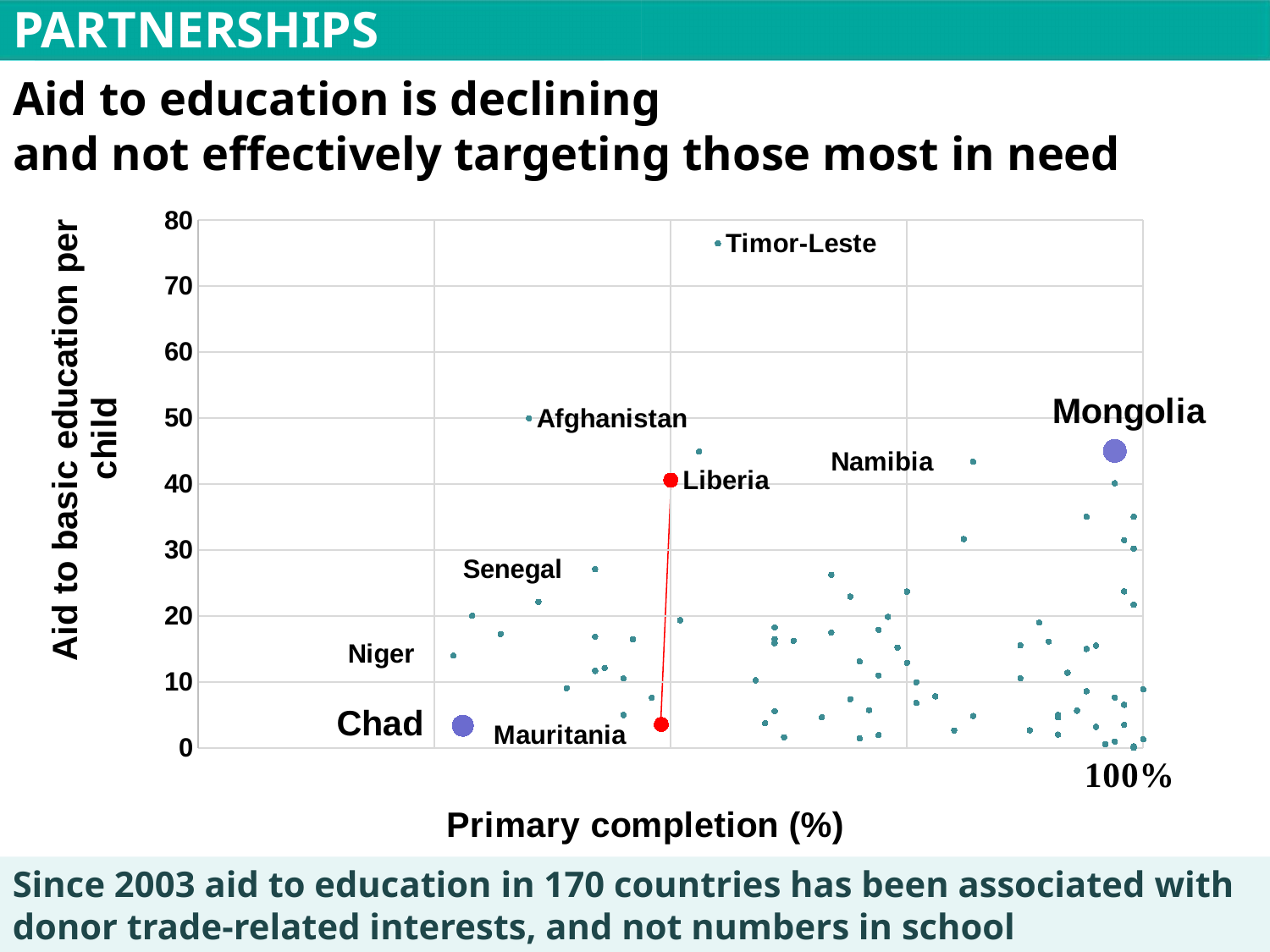
Is the aid to basic education per child for Niger greater or less than 10? greater Is the aid to basic education per child for Senegal greater or less than 30? less Which labelled country has the highest aid to basic education per child? Timor-Leste Which has higher aid to basic education per child, Chad or Mongolia? Mongolia What is the title of the vertical axis of the chart? Aid to basic education per child What is the title of the horizontal axis of the chart? Primary completion (%) What kind of chart is shown on the slide? scatter plot Is the aid to basic education per child for Chad greater or less than 10? less How many countries are labelled by name on the chart? 9 Which has higher aid to basic education per child, Afghanistan or Liberia? Afghanistan